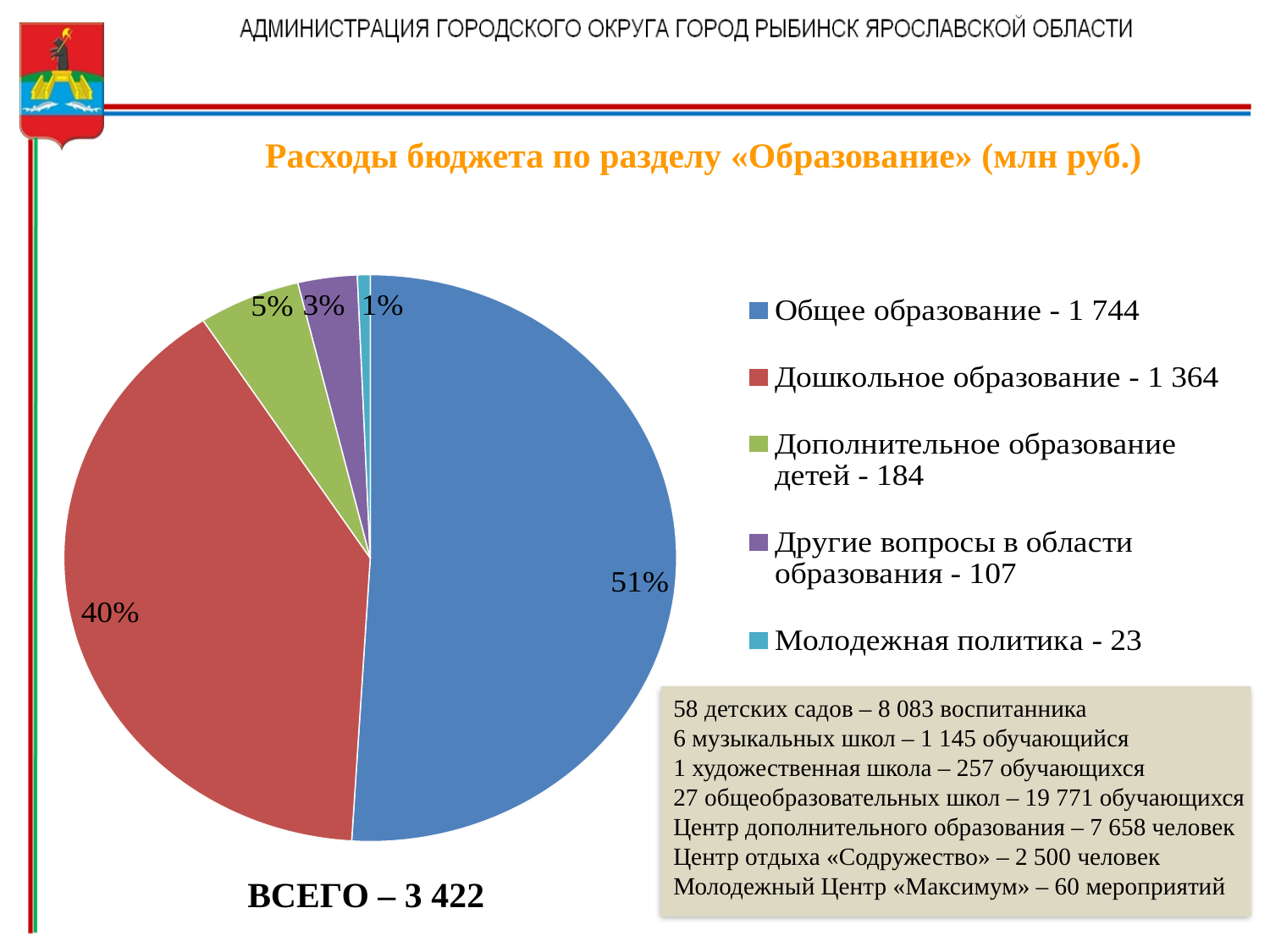
Which category has the smallest slice of the pie? Молодежная политика What is the difference between the values for «Общее образование» and «Дошкольное образование»? 380 What value does the legend give for «Другие вопросы в области образования»? 107 What kind of chart is shown on the slide? pie chart Which category has the largest slice of the pie? Общее образование Which is larger, the value for «Дополнительное образование детей» or for «Другие вопросы в области образования»? Дополнительное образование детей How many slices does the pie chart have? 5 What share of the pie does «Общее образование» take? 51% What share of the pie does «Дополнительное образование детей» take? 5% What total (ВСЕГО) is shown below the pie chart? 3 422 What share of the pie does «Дошкольное образование» take? 40% What value does the legend give for «Молодежная политика»? 23